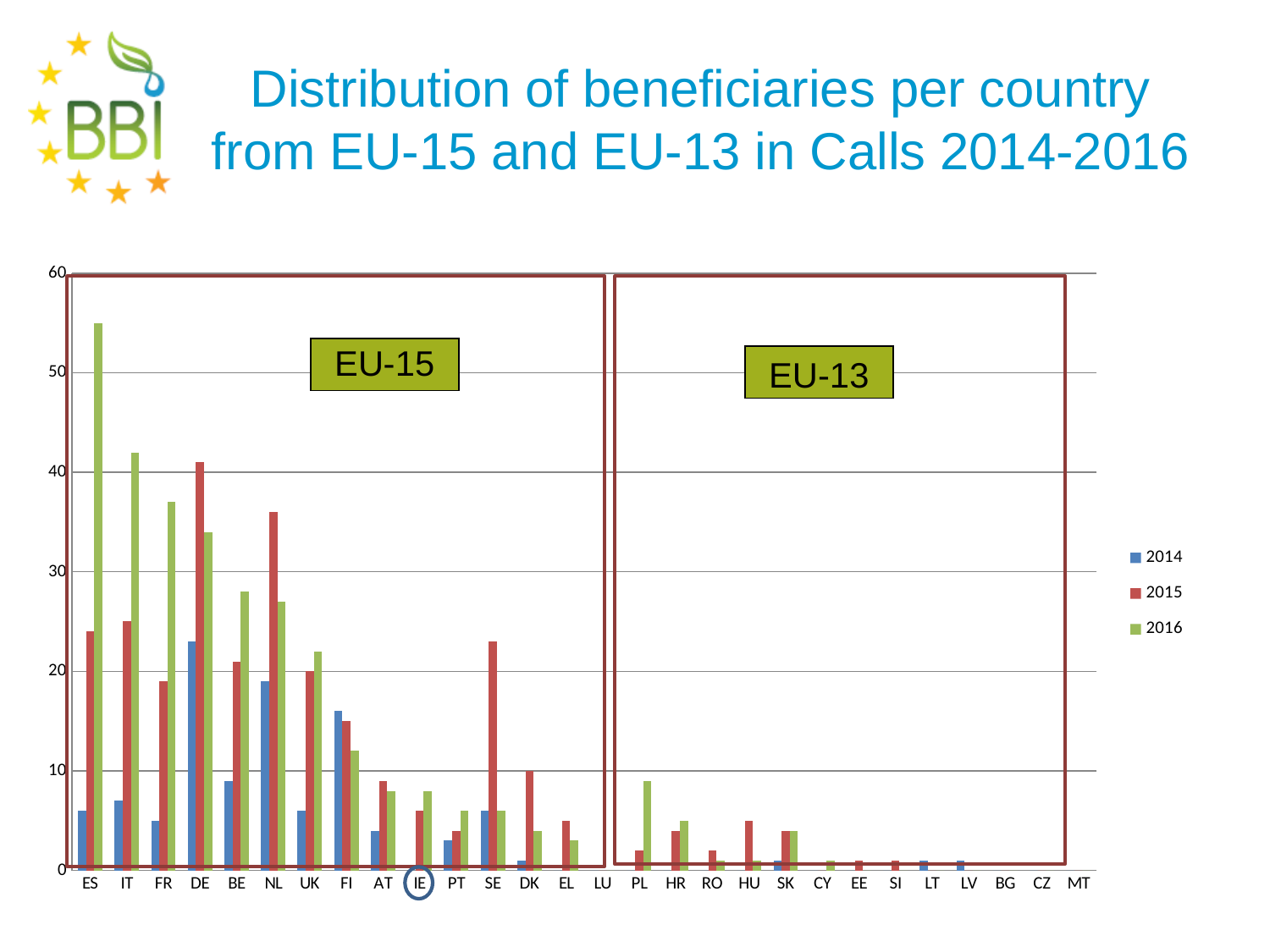
Is the 2015 value for NL greater or less than 30? greater Which country has the highest value for the 2015 series? DE Which country has the tallest bar in the chart? ES Which years are listed in the legend? 2014, 2015, 2016 Which two country groups are labelled inside the chart area? EU-15 and EU-13 Which is larger, the 2016 value for ES or the 2016 value for IT? ES Is the 2016 value for PL greater or less than 10? less How many series does the legend list? 3 What kind of chart is shown on the slide? bar chart Is the 2016 value for ES greater or less than 50? greater How many countries are shown on the x axis? 28